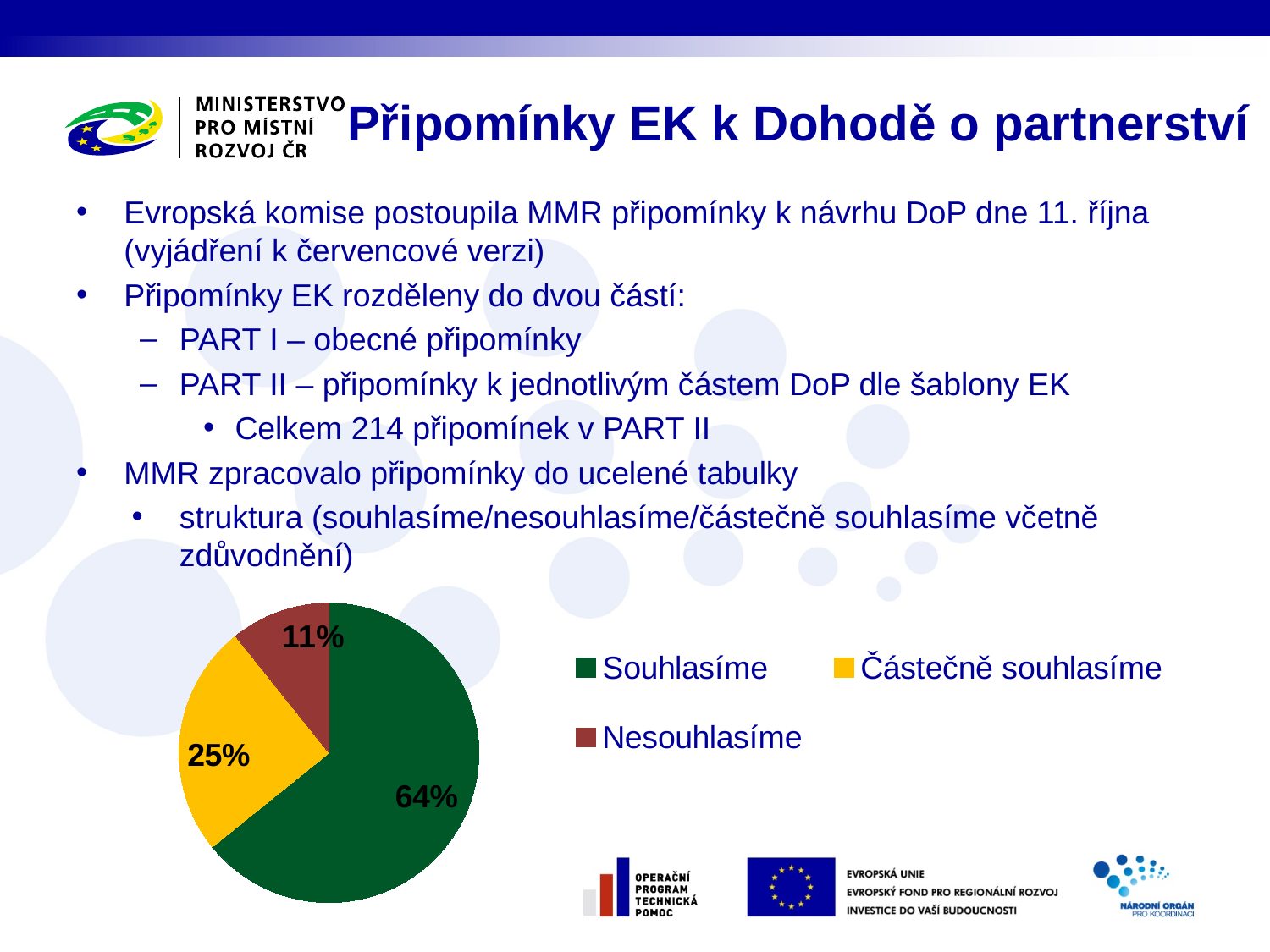
Which category has the largest slice of the pie? Souhlasíme What is the difference in percentage points between Částečně souhlasíme and Nesouhlasíme? 14 How many entries does the legend list? 3 How many slices does the pie chart have? 3 What kind of chart is shown on the slide? pie chart What colour is the slice for Částečně souhlasíme? yellow What is the difference in percentage points between Souhlasíme and Částečně souhlasíme? 39 What share of the pie does Nesouhlasíme have? 11% What share of the pie does Částečně souhlasíme have? 25% What share of the pie does Souhlasíme have? 64% Which category has the smallest slice of the pie? Nesouhlasíme Which is larger, the slice for Částečně souhlasíme or the slice for Nesouhlasíme? Částečně souhlasíme